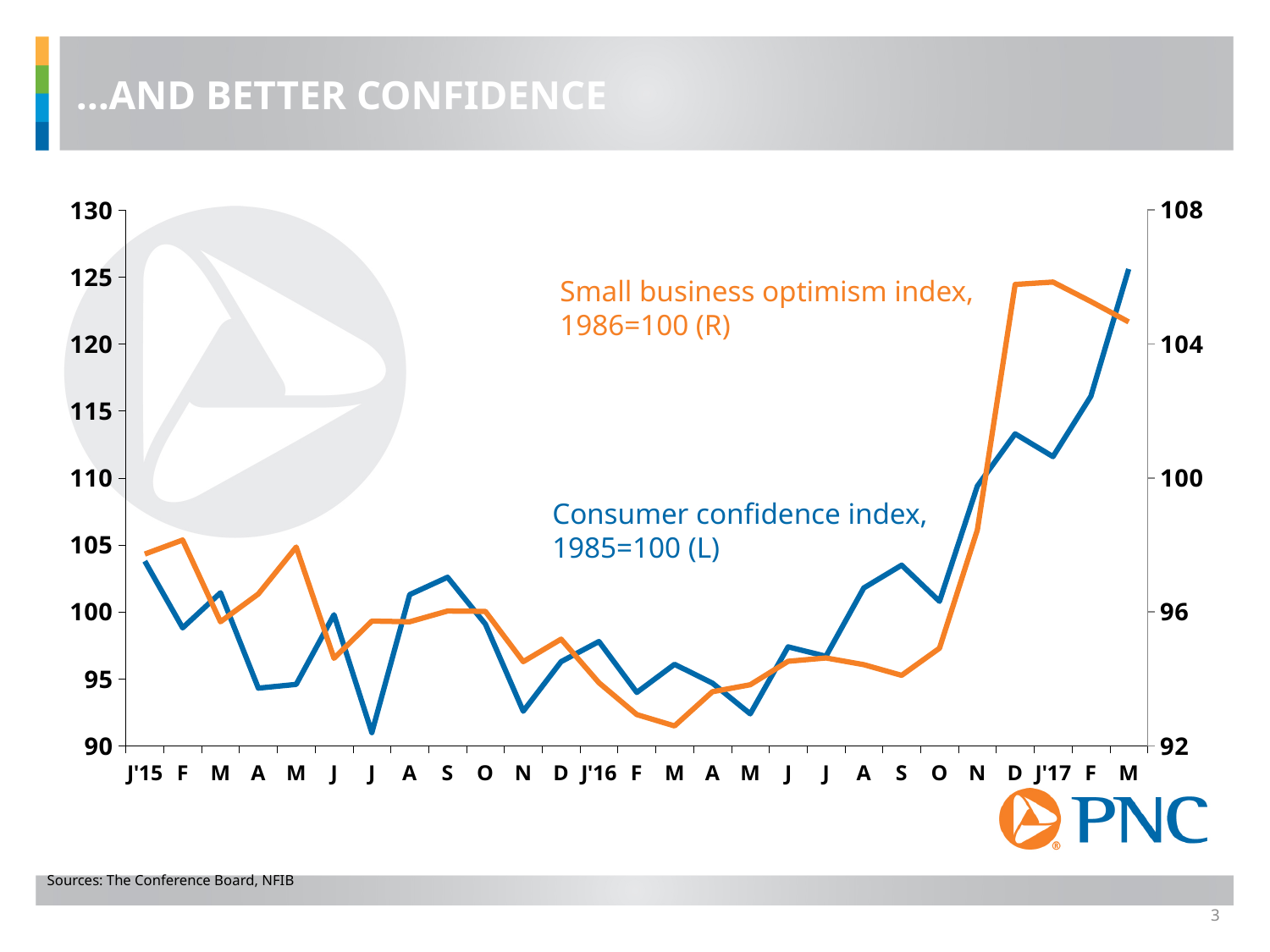
Is the value of the Consumer confidence index in M (March 2017), the last point, greater or less than 120? greater Is the value of the Small business optimism index in D (December 2016) greater or less than 104? greater In which month does the Consumer confidence index reach its highest value? M (March 2017) Is the value of the Consumer confidence index in J'15 greater or less than 100? greater Does the Consumer confidence index rise or fall from O (October 2016) to M (March 2017)? rise Which axis, left or right, is used for the Small business optimism index? Right What colour is the line for the Consumer confidence index? Blue How many months are shown along the x axis of the chart? 27 In which month does the Consumer confidence index reach its lowest value? J (July 2015) How many series are plotted on the chart? 2 What kind of chart is shown on the slide? Line chart